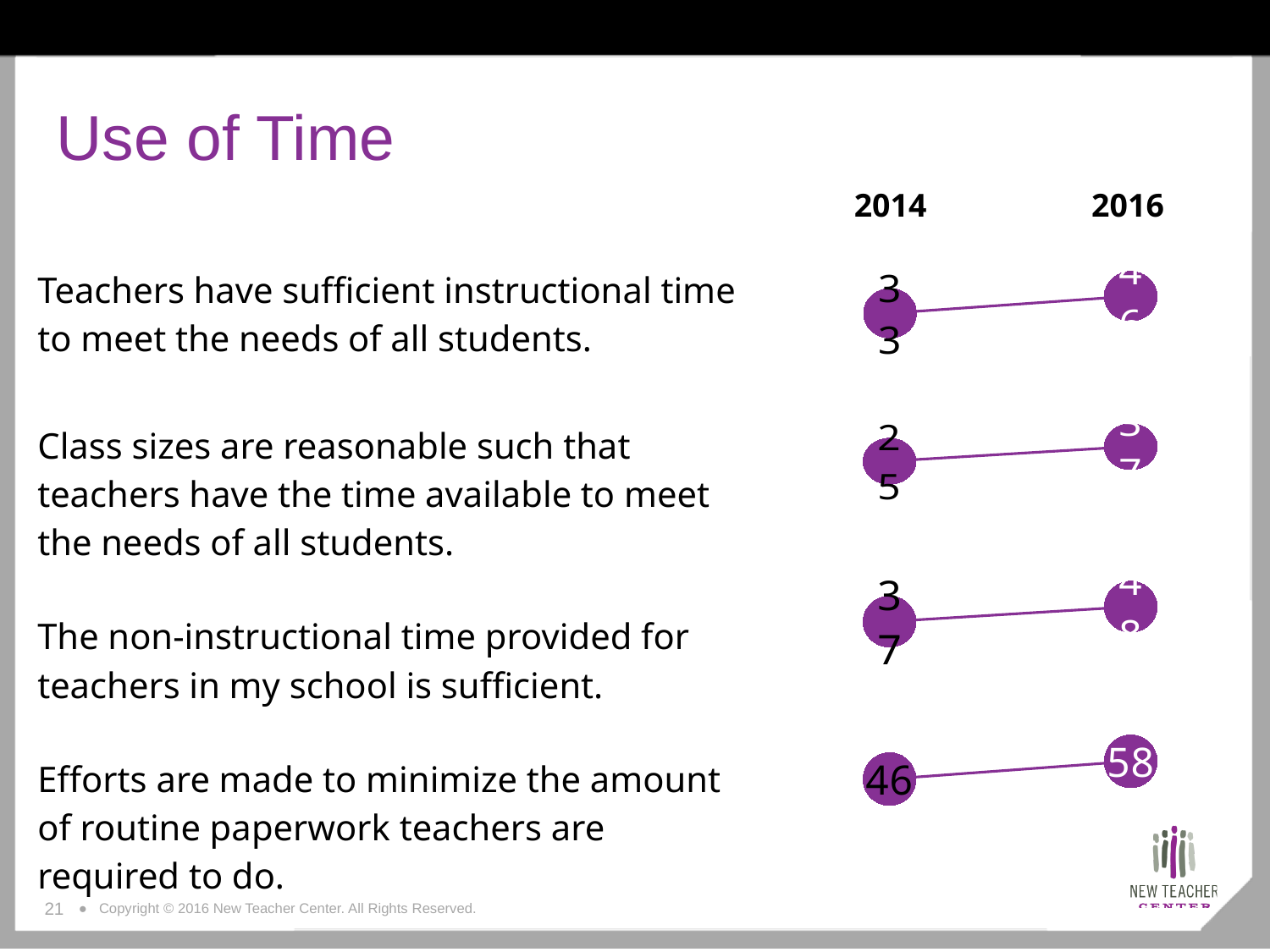
What is the 2014 value for the statement 'Class sizes are reasonable such that teachers have the time available to meet the needs of all students'? 25 Which statement has the highest 2014 value? Efforts are made to minimize the amount of routine paperwork teachers are required to do What is the 2014 value for the statement 'Efforts are made to minimize the amount of routine paperwork teachers are required to do'? 46 How many statements are plotted on the slide? 4 Which two years are compared in the charts on the slide? 2014 and 2016 Do the values for the statements rise or fall from 2014 to 2016? rise Which statement has the lowest 2014 value? Class sizes are reasonable such that teachers have the time available to meet the needs of all students For the routine paperwork statement, which year has the higher value, 2014 or 2016? 2016 What is the 2014 value for the statement 'Teachers have sufficient instructional time to meet the needs of all students'? 33 What is the 2014 value for the statement 'The non-instructional time provided for teachers in my school is sufficient'? 37 For the routine paperwork statement, by how much did the value change from 2014 to 2016? 12 What is the 2016 value for the statement 'Efforts are made to minimize the amount of routine paperwork teachers are required to do'? 58